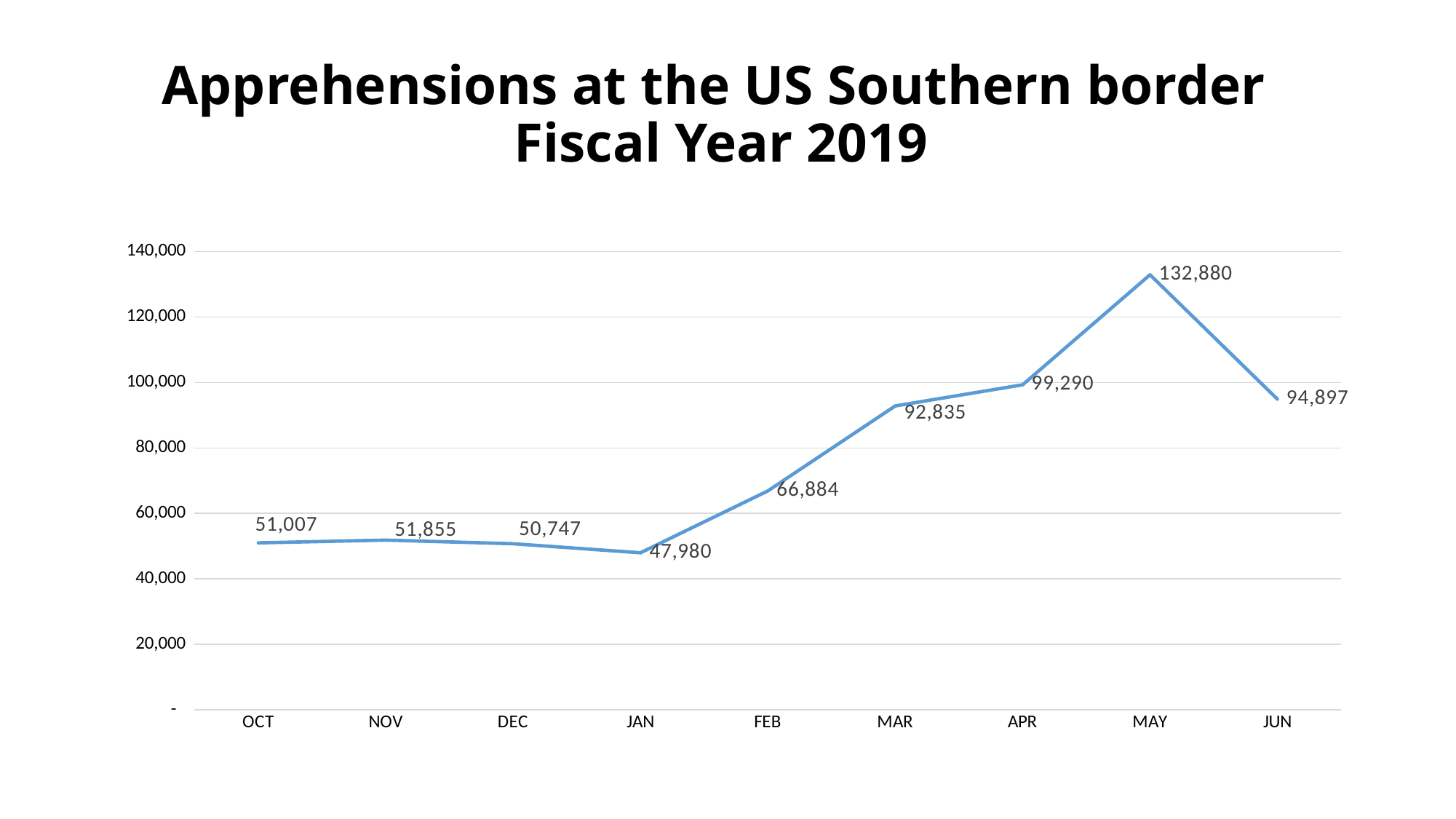
What is the title of the chart? Apprehensions at the US Southern border Fiscal Year 2019 What is the value for FEB? 66,884 What is the difference between the values for APR and MAR? 6,455 Which month has the lowest value? JAN What is the difference between the values for MAY and JUN? 37,983 What kind of chart is shown on the slide? line chart What is the value for JAN? 47,980 What is the value for MAY? 132,880 Which month has the highest value? MAY How many months are plotted on the chart? 9 Which is larger, the value for NOV or the value for DEC? NOV Is the value for MAR greater or less than 80,000? greater